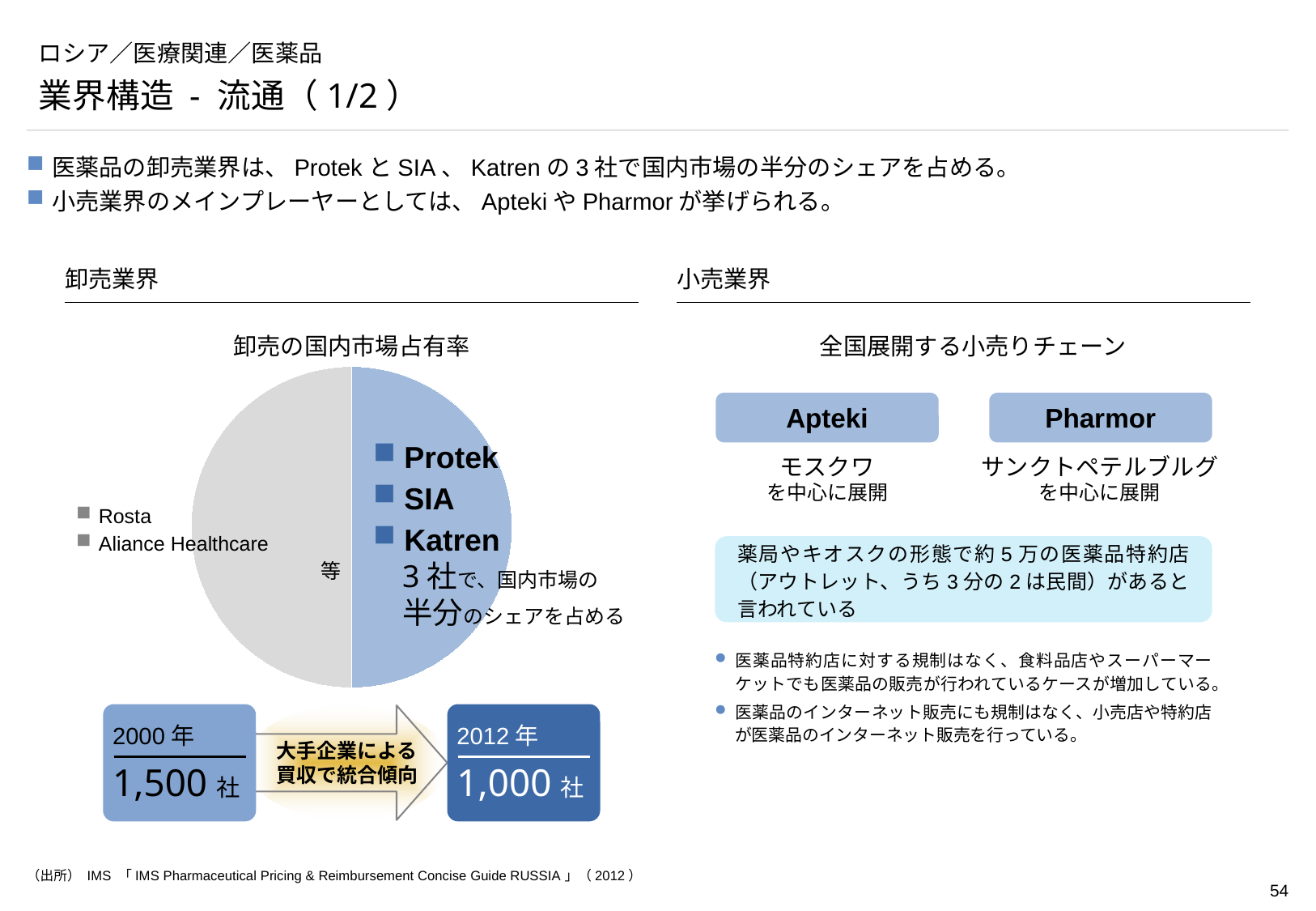
What kind of chart is shown under the heading 卸売の国内市場占有率? Pie chart In the pie chart 卸売の国内市場占有率, which companies are listed for the grey slice? Rosta, Aliance Healthcare 等 How many slices does the pie chart 卸売の国内市場占有率 have? 2 In the pie chart 卸売の国内市場占有率, what share of the domestic market do Protek, SIA and Katren together hold? 半分 In the pie chart 卸売の国内市場占有率, how many companies are named in the blue slice? 3 What is the title of the pie chart on the left side of the slide? 卸売の国内市場占有率